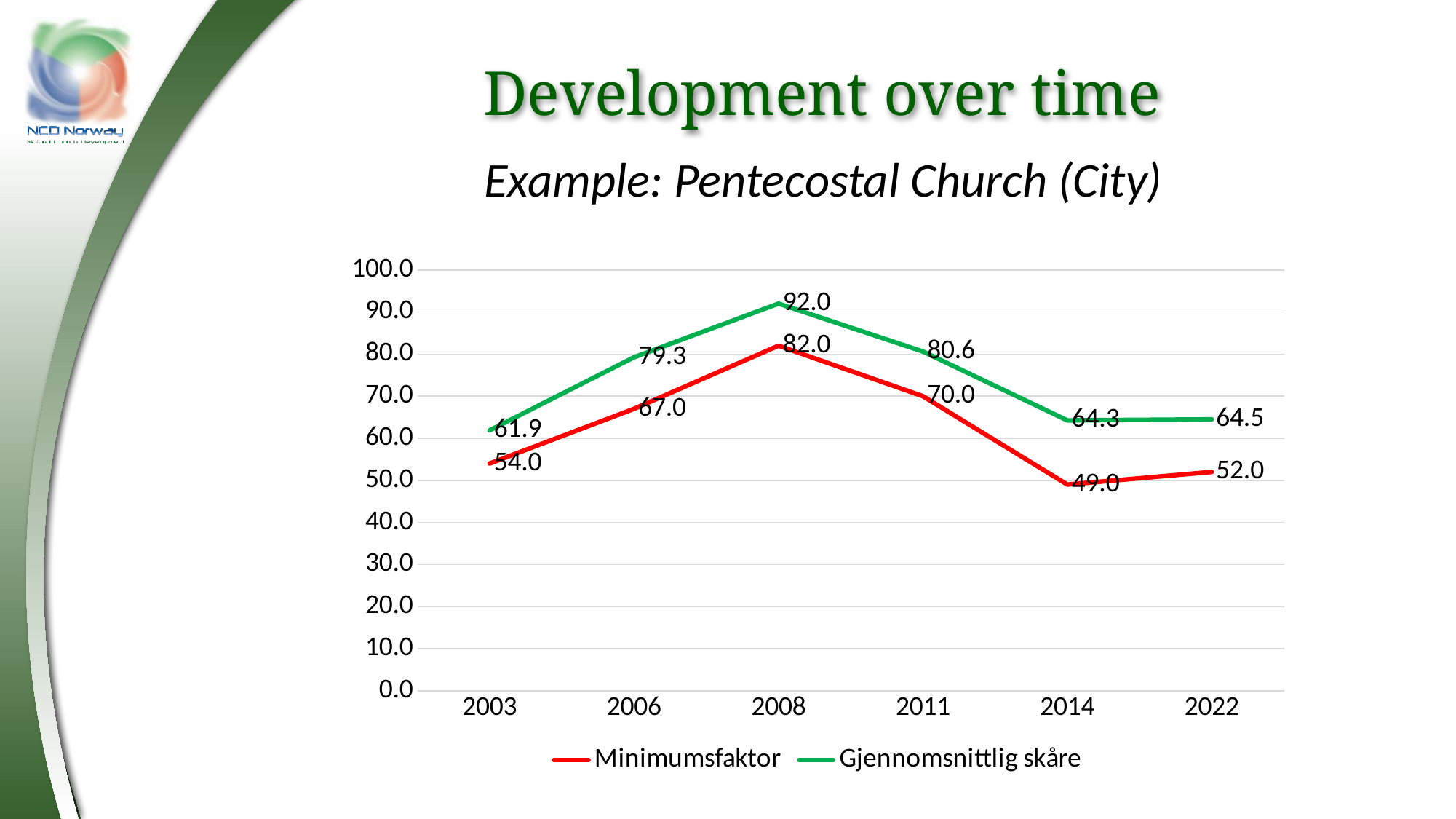
In which year is the Minimumsfaktor lowest? 2014 In which year is the Gjennomsnittlig skåre highest? 2008 What is the difference between Gjennomsnittlig skåre and Minimumsfaktor in 2011? 10.6 What is the Gjennomsnittlig skåre value for 2003? 61.9 How many years are shown on the x axis? 6 Which is larger: the Minimumsfaktor in 2006 or in 2011? 2011 What kind of chart is shown on the slide? Line chart Does the Minimumsfaktor rise or fall from 2008 to 2014? Fall What colour is the Gjennomsnittlig skåre line? Green What is the Minimumsfaktor value for 2008? 82.0 What is the Minimumsfaktor value for 2022? 52.0 How many series does the legend list? 2